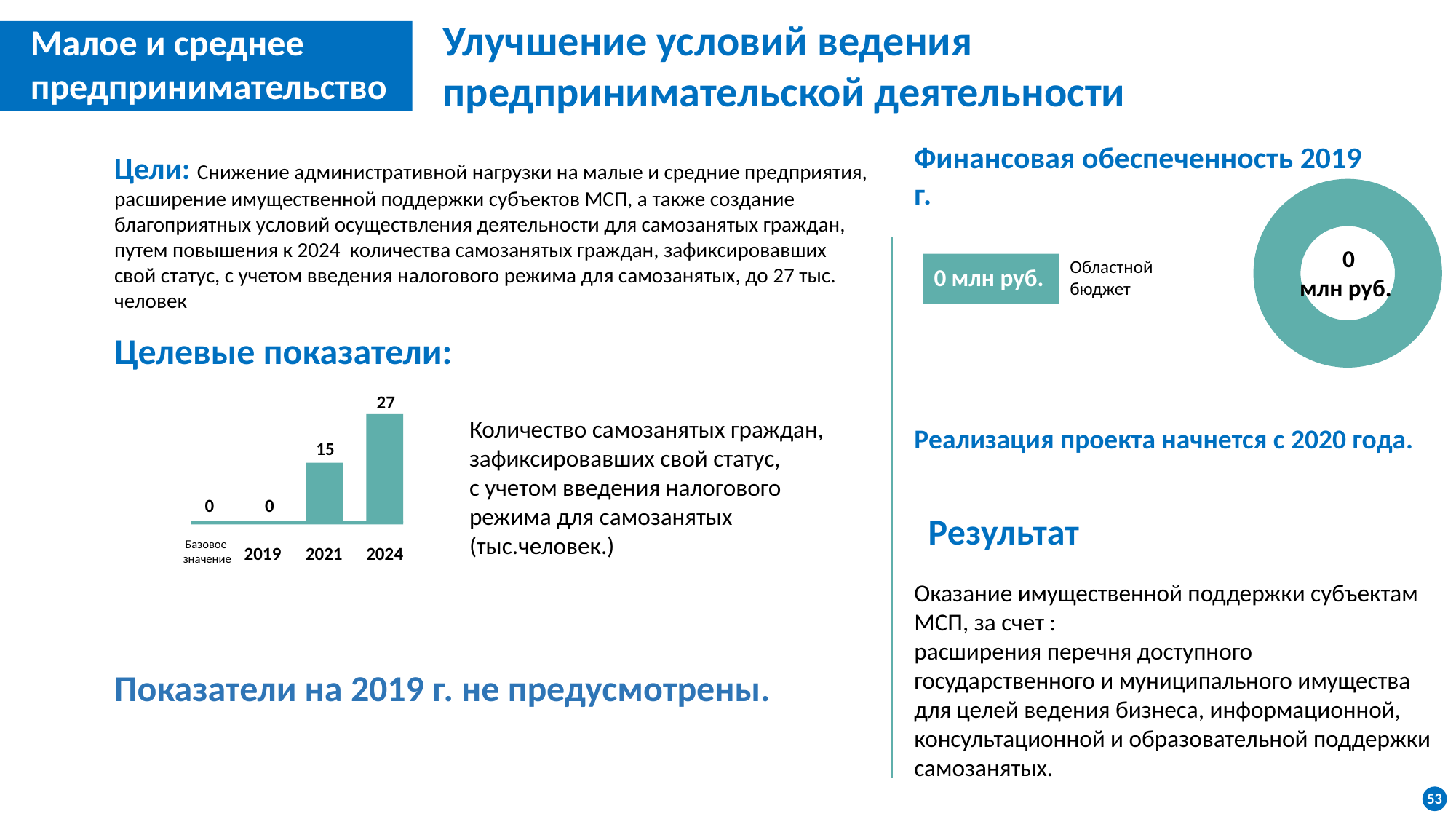
In the bar chart under 'Целевые показатели', what is the value for 2024? 27 In the bar chart under 'Целевые показатели', what is the difference between the values for 2024 and 2021? 12 In the bar chart under 'Целевые показатели', what is the value for 'Базовое значение'? 0 What unit is given in the text next to the bar chart under 'Целевые показатели'? тыс.человек In the bar chart under 'Целевые показатели', which is larger, the value for 2021 or the value for 2024? 2024 In the bar chart under 'Целевые показатели', which category has the highest value? 2024 How many categories are shown on the x axis of the bar chart under 'Целевые показатели'? 4 What kind of chart is shown under 'Целевые показатели'? bar chart In the bar chart under 'Целевые показатели', what is the value for 2021? 15 In the bar chart under 'Целевые показатели', what is the value for 2019? 0 In the bar chart under 'Целевые показатели', do the values rise or fall from 2019 to 2024? rise What value is shown in the centre of the donut chart under 'Финансовая обеспеченность 2019 г.'? 0 млн руб.